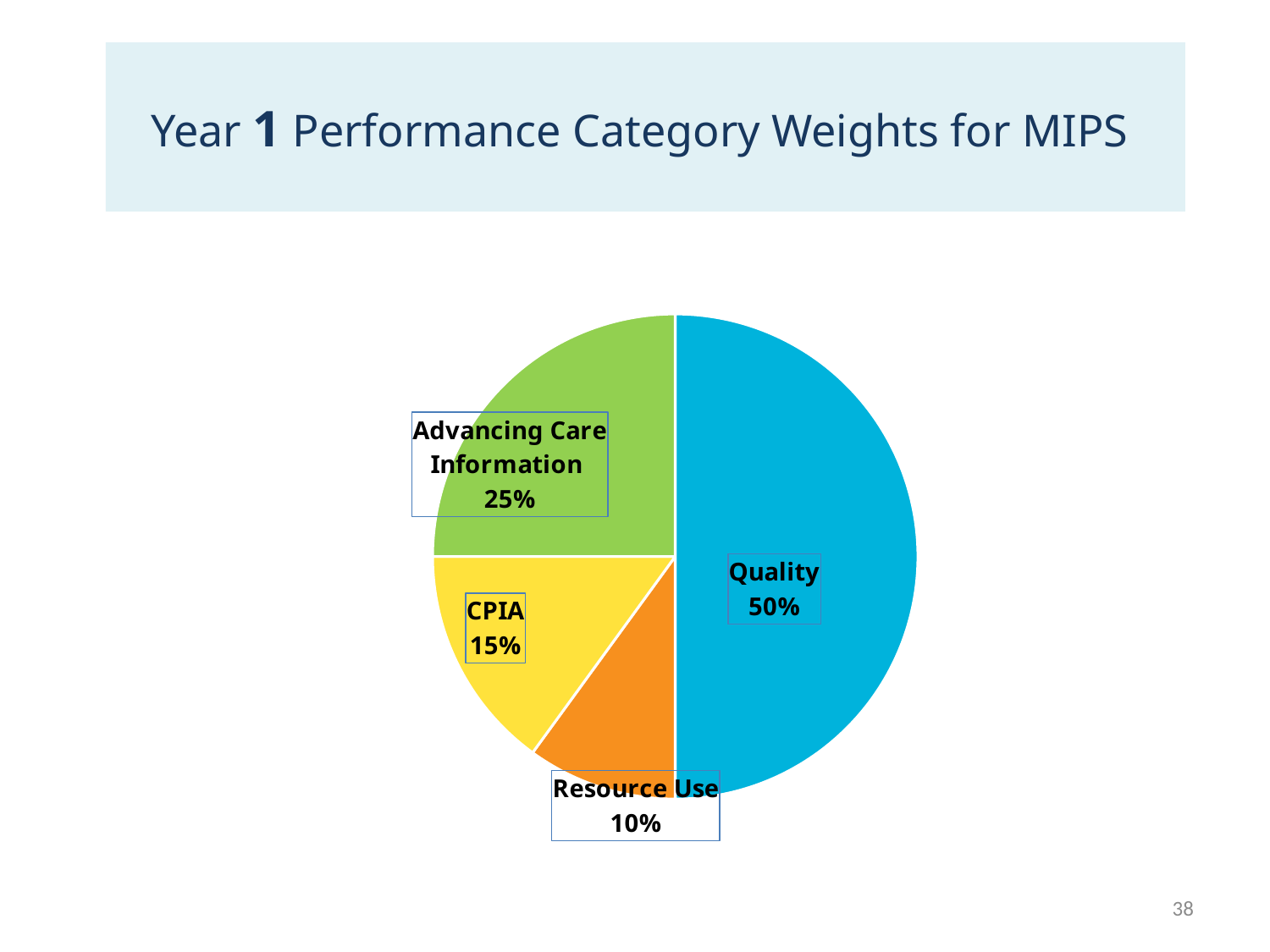
What is the weight for Quality? 50% What share of the pie does Advancing Care Information represent? 25% What kind of chart is shown on the slide? pie chart Which is larger, the weight for CPIA or the weight for Resource Use? CPIA Which category has the smallest share of the pie? Resource Use What is the weight for CPIA? 15% What is the difference between the Quality weight and the Advancing Care Information weight? 25% What is the title of the slide containing the pie chart? Year 1 Performance Category Weights for MIPS How many categories are shown in the pie chart? 4 What is the weight for Advancing Care Information? 25% Which category has the largest share of the pie? Quality What is the weight for Resource Use? 10%